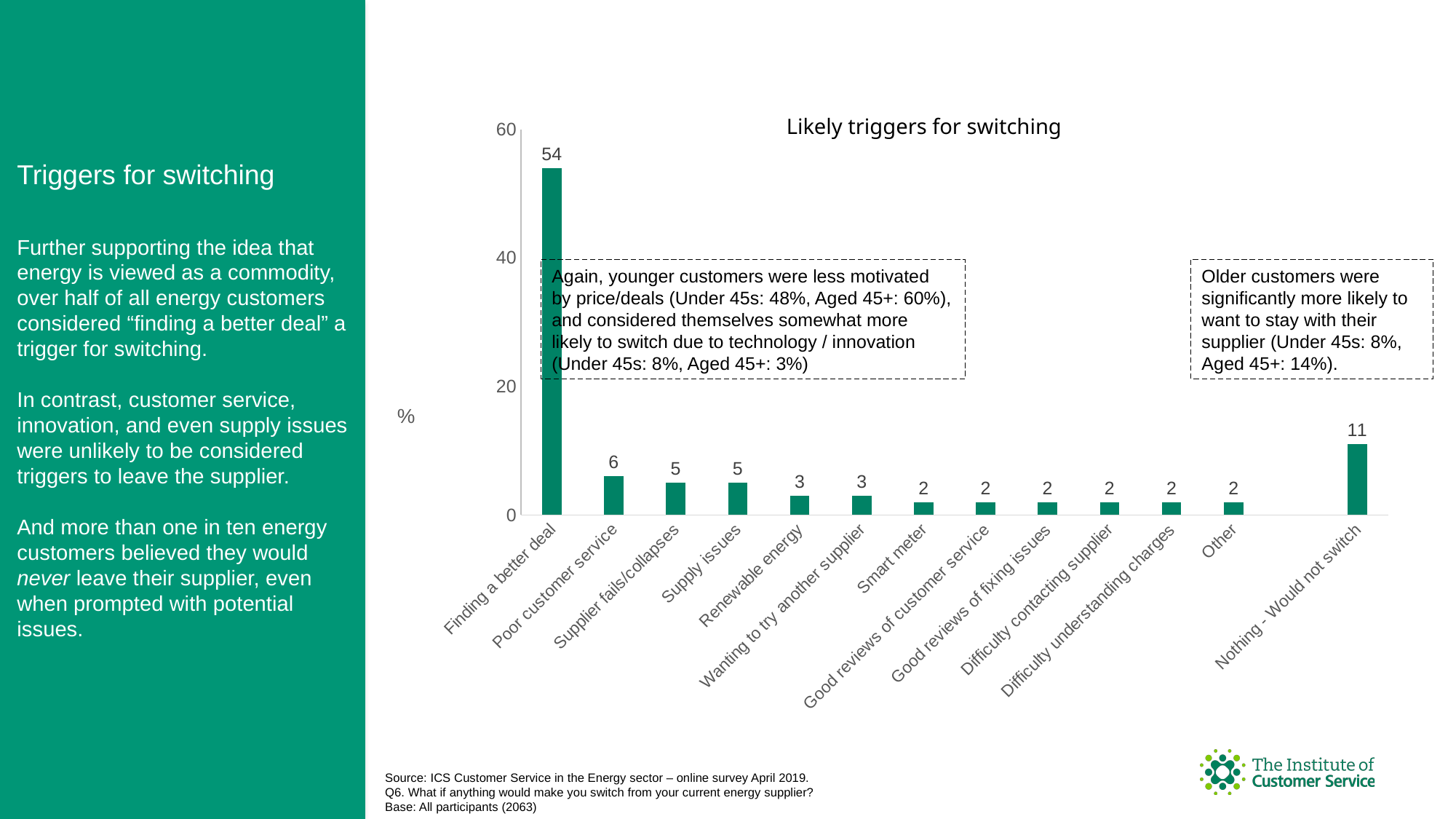
What kind of chart is shown? Bar chart Which is larger, "Poor customer service" or "Supply issues"? Poor customer service What is the value for "Finding a better deal" in the Likely triggers for switching chart? 54 What is the title of the chart? Likely triggers for switching What is the difference between "Finding a better deal" and "Nothing - Would not switch"? 43 What is the value for "Poor customer service"? 6 What is the value for "Renewable energy"? 3 What is the value for "Nothing - Would not switch"? 11 Which category has the highest value? Finding a better deal How many categories are shown on the x axis? 13 What is the difference between "Supplier fails/collapses" and "Smart meter"? 3 Is the value for "Finding a better deal" greater or less than 40? greater